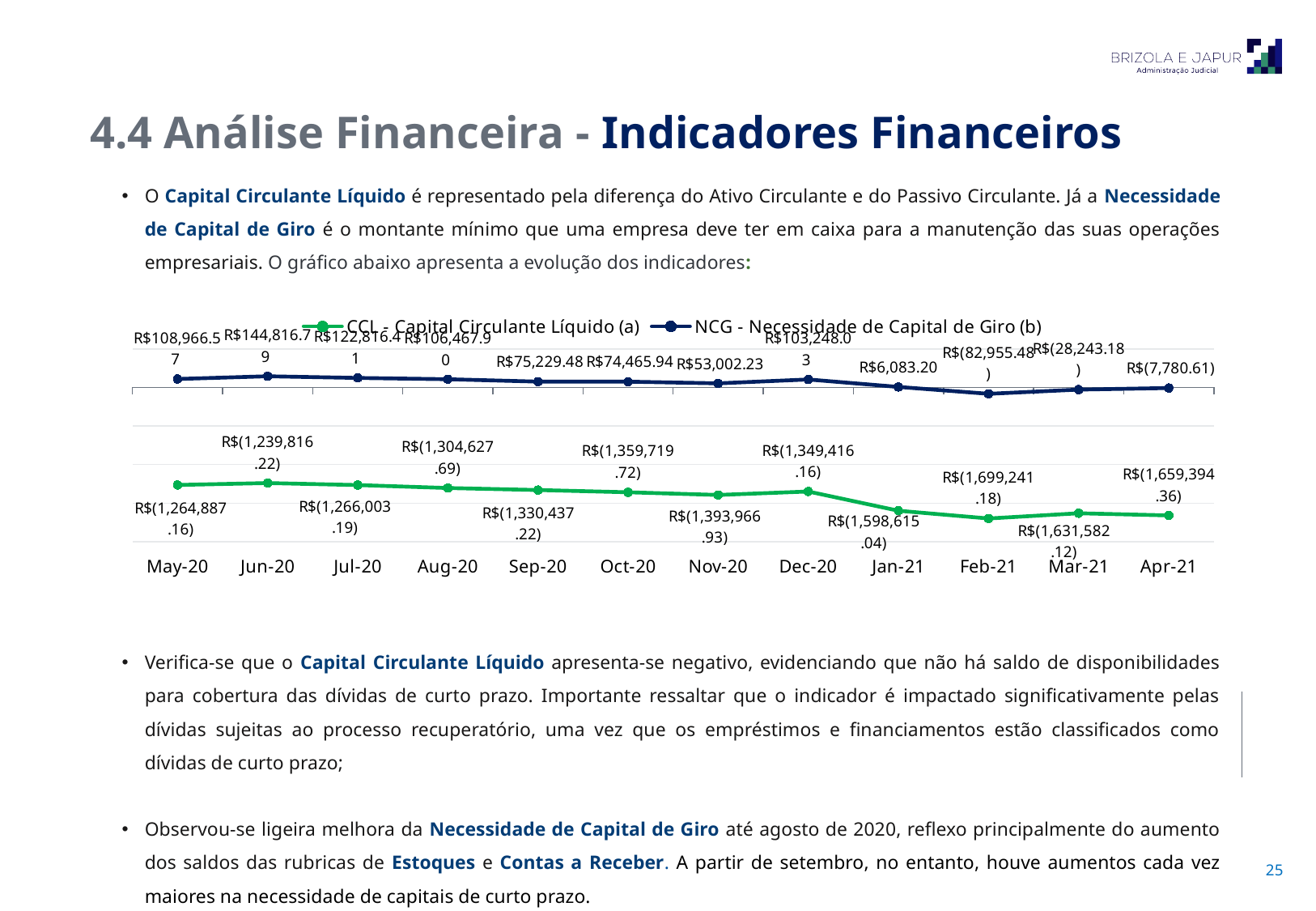
How many months are plotted on the x axis of the chart? 12 Does the NCG - Necessidade de Capital de Giro series generally rise or fall from May-20 to Apr-21? Fall What is the value of NCG - Necessidade de Capital de Giro for Jan-21? R$6,083.20 Which is larger, the NCG value for Nov-20 or for Dec-20? Dec-20 What kind of chart is shown on the slide? Line chart What is the value of NCG - Necessidade de Capital de Giro for Nov-20? R$53,002.23 What is the value of NCG - Necessidade de Capital de Giro for Sep-20? R$75,229.48 In which month is NCG - Necessidade de Capital de Giro highest? Jun-20 In which month is NCG - Necessidade de Capital de Giro lowest? Feb-21 How many series does the chart legend list? 2 What is the value of CCL - Capital Circulante Líquido for Feb-21? R$(1,699,241.18) What is the difference between the NCG values for Sep-20 and Oct-20? R$763.54